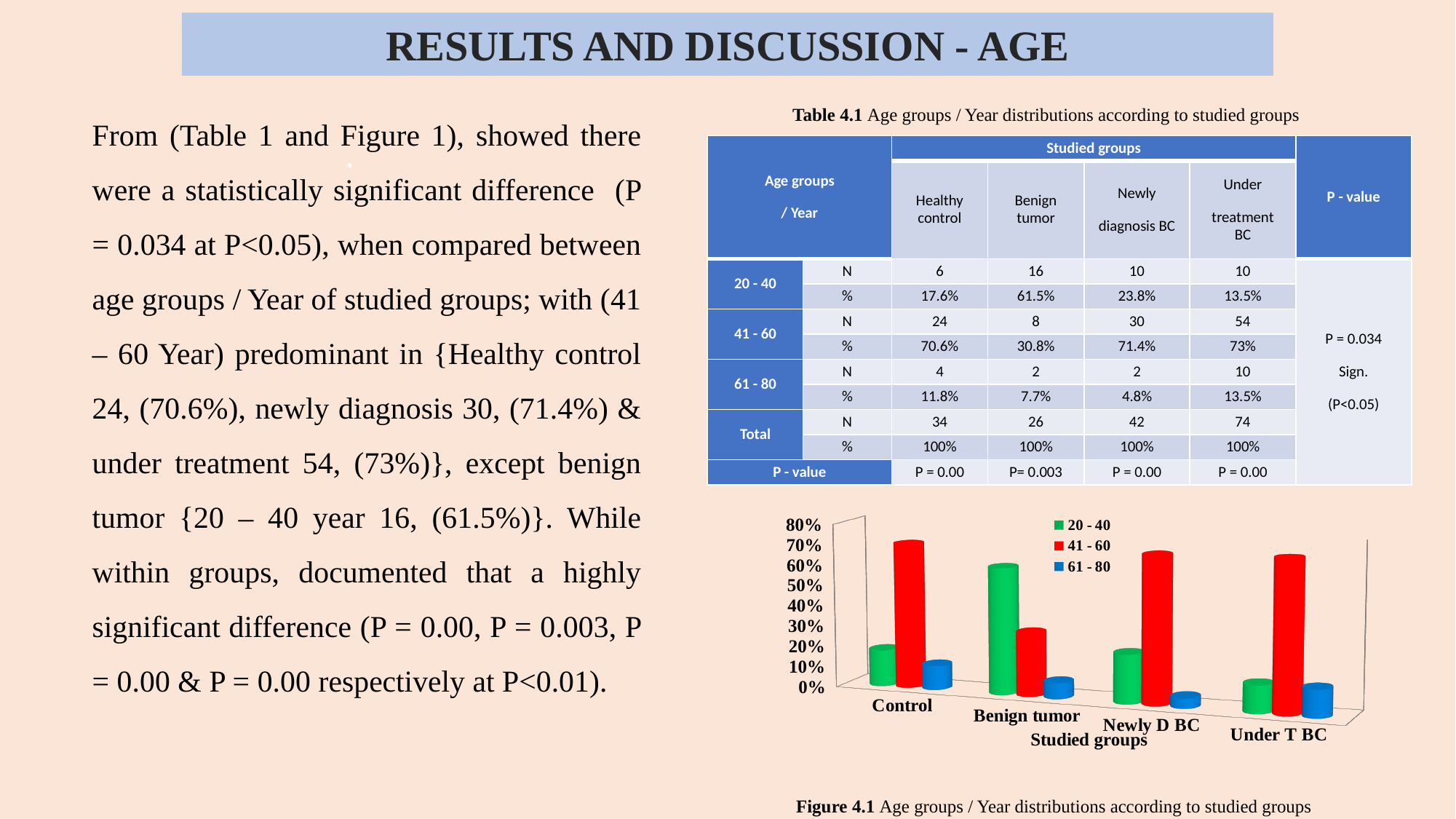
In Figure 4.1, which age group has the highest bar for Benign tumor? 20 - 40 How many studied groups are shown along the x axis of Figure 4.1? 4 In Figure 4.1, is the 20 - 40 value for Newly D BC greater or less than 30%? less In Figure 4.1, is the 41 - 60 value for Benign tumor greater or less than 40%? less In Figure 4.1, which age group has the lowest bar for Newly D BC? 61 - 80 How many series does the legend of Figure 4.1 list? 3 In Figure 4.1, what colour represents the 41 - 60 age group? red In Figure 4.1, is the 41 - 60 value for Control greater or less than 60%? greater What kind of chart is Figure 4.1? bar chart In Figure 4.1, which age group has the highest bar for Control? 41 - 60 In Figure 4.1, which is larger: the 41 - 60 bar for Benign tumor or the 41 - 60 bar for Newly D BC? Newly D BC In Figure 4.1, which is larger: the 20 - 40 bar for Control or the 20 - 40 bar for Benign tumor? Benign tumor